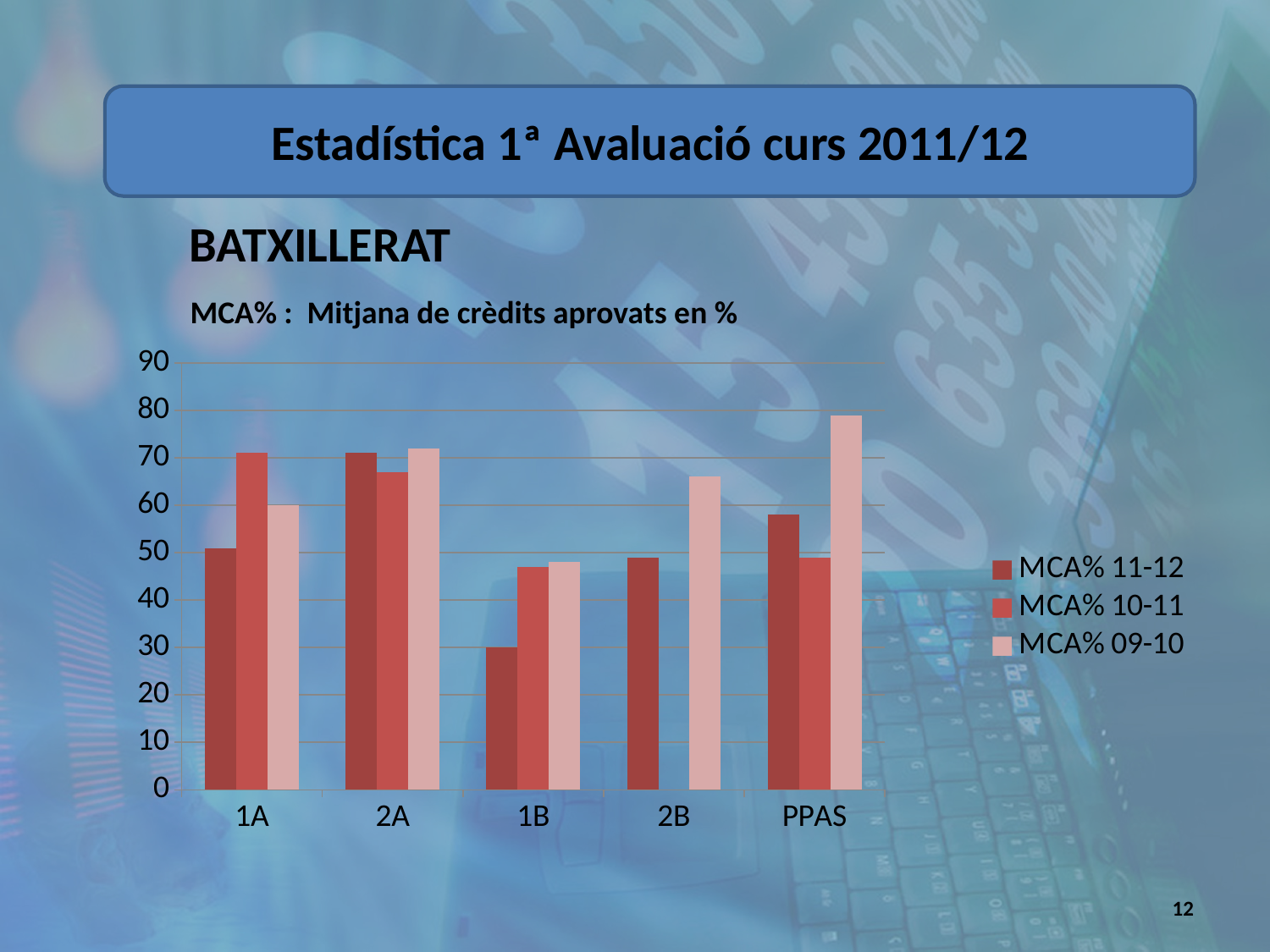
What are the three series listed in the chart's legend? MCA% 11-12, MCA% 10-11, MCA% 09-10 Is the MCA% 09-10 value for 2B greater or less than 60? greater For PPAS, which is larger: the MCA% 11-12 value or the MCA% 09-10 value? MCA% 09-10 Is the MCA% 09-10 value for PPAS greater or less than 70? greater How many categories are shown on the x axis of the chart? 5 For 1A, which is larger: the MCA% 11-12 value or the MCA% 10-11 value? MCA% 10-11 Is the MCA% 11-12 value for 1B greater or less than 40? less How many series does the chart's legend list? 3 Which category has the lowest value for MCA% 11-12? 1B Which category has the highest value for MCA% 09-10? PPAS What kind of chart is shown on the slide? bar chart